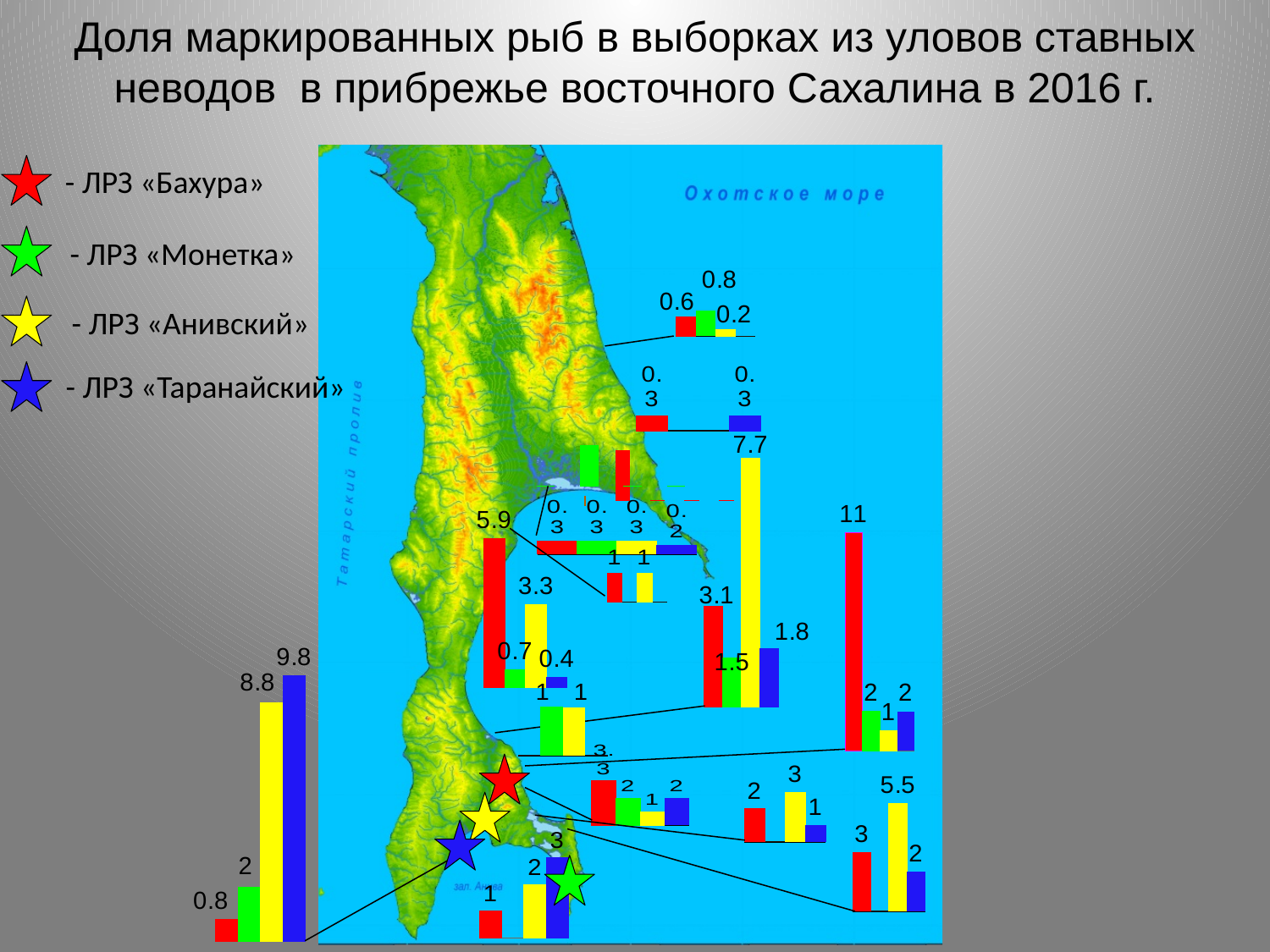
What kind of charts are placed on the map? bar charts In the chart at the top of the map near the northeast coast, what is the value of the green bar? 0.8 In the chart with the yellow bar labelled 7.7, what is the difference between the yellow bar and the red bar (3.1)? 4.6 How many hatcheries (ЛРЗ) does the legend on the left list? 4 In the bar chart at the bottom-left corner of the slide, what is the difference between the blue bar (9.8) and the yellow bar (8.8)? 1 In the chart on the right side of the map with the tallest red bar, what is the value of that red bar? 11 In the chart in the middle of the map with the yellow bar labelled 7.7, what is the value of the red bar? 3.1 In the bar chart at the bottom-left corner of the slide, what is the value of the blue bar? 9.8 In the bar chart at the bottom-left corner of the slide, which bar has the lowest value? the red bar (0.8) In the chart at the bottom-right of the map, what is the value of the yellow bar? 5.5 In the chart on the right side of the map with the red bar labelled 11, which is larger, the red bar or the blue bar? the red bar In the chart on the left side of the map with the red bar labelled 5.9, what is the value of the yellow bar? 3.3